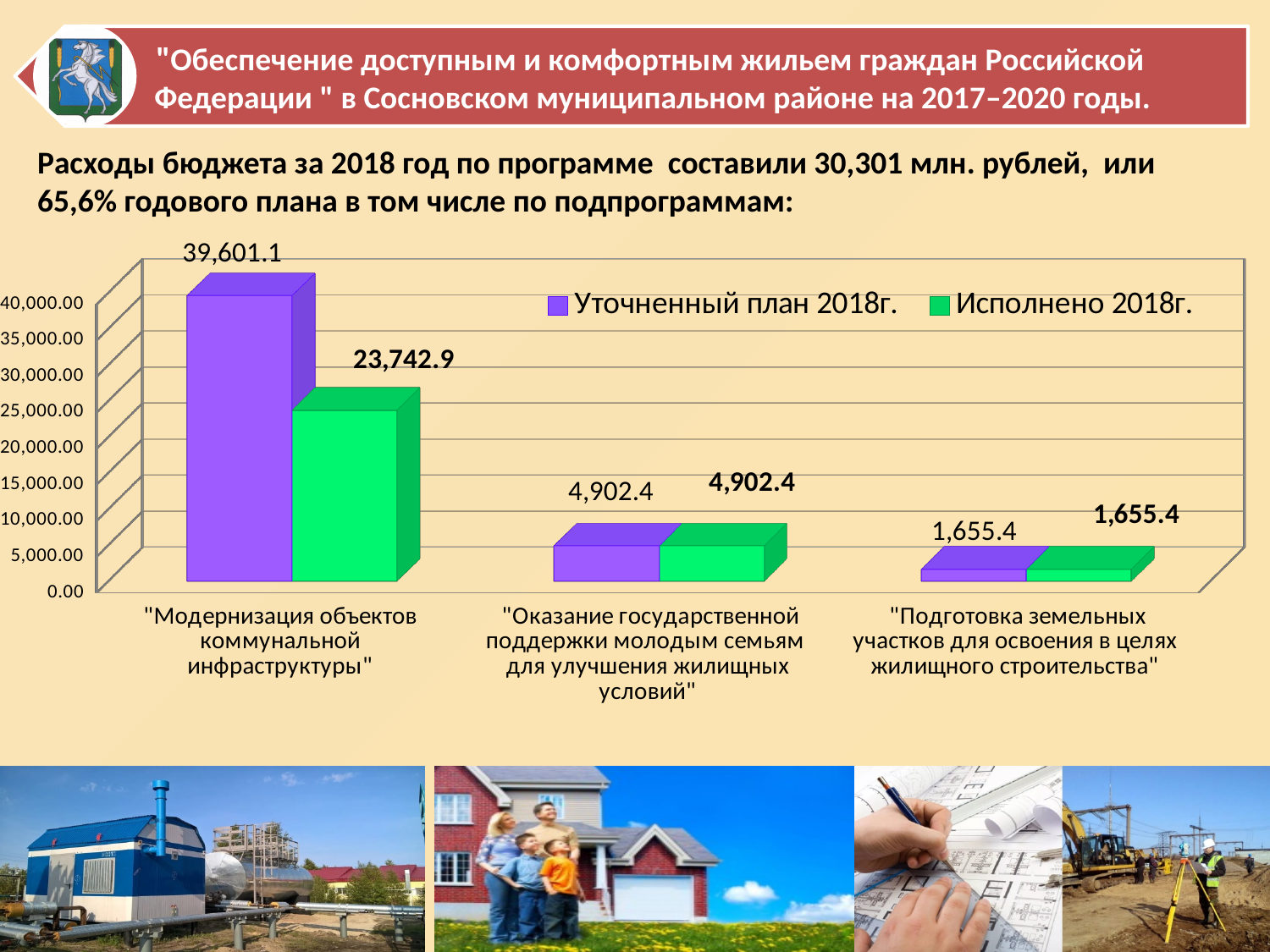
What is the value of "Исполнено 2018г." for "Модернизация объектов коммунальной инфраструктуры"? 23,742.9 How many categories are shown on the x axis of the chart? 3 Which category has the lowest value for "Исполнено 2018г."? "Подготовка земельных участков для освоения в целях жилищного строительства" What is the value of "Уточненный план 2018г." for "Подготовка земельных участков для освоения в целях жилищного строительства"? 1,655.4 How many series does the chart legend list? 2 Is the value of "Исполнено 2018г." for "Модернизация объектов коммунальной инфраструктуры" greater or less than 20,000.00? greater What kind of chart is shown on the slide? bar chart Which category has the highest value for "Уточненный план 2018г."? "Модернизация объектов коммунальной инфраструктуры" What is the value of "Исполнено 2018г." for "Оказание государственной поддержки молодым семьям для улучшения жилищных условий"? 4,902.4 Which is larger for "Модернизация объектов коммунальной инфраструктуры": "Уточненный план 2018г." or "Исполнено 2018г."? Уточненный план 2018г. What is the value of "Уточненный план 2018г." for "Модернизация объектов коммунальной инфраструктуры"? 39,601.1 What is the difference between "Уточненный план 2018г." and "Исполнено 2018г." for "Модернизация объектов коммунальной инфраструктуры"? 15,858.2